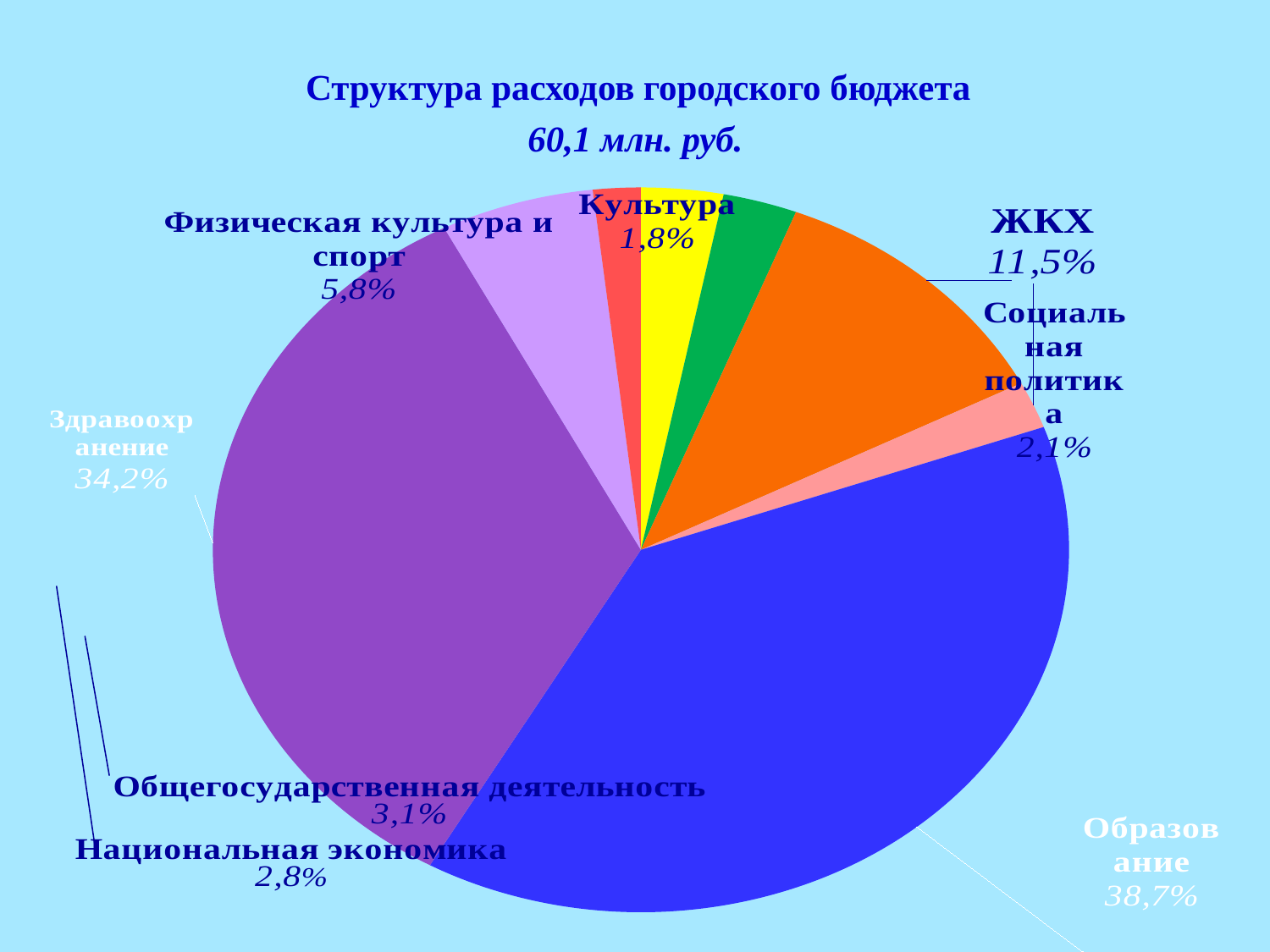
Which category has the smallest share of the city budget expenditure? Культура What share of the city budget expenditure goes to Здравоохранение? 34,2% What share of the city budget expenditure goes to ЖКХ? 11,5% What share of the city budget expenditure goes to Образование? 38,7% What is the difference in percentage points between the shares of Образование and Здравоохранение? 4,5% What share of the city budget expenditure goes to Социальная политика? 2,1% What type of chart is shown on the slide? pie chart What is the title of the chart? Структура расходов городского бюджета 60,1 млн. руб. How many categories are shown in the pie chart? 8 What share of the city budget expenditure goes to Культура? 1,8% Which category has the largest share of the city budget expenditure? Образование Which has a larger share of the budget, Физическая культура и спорт or Общегосударственная деятельность? Физическая культура и спорт